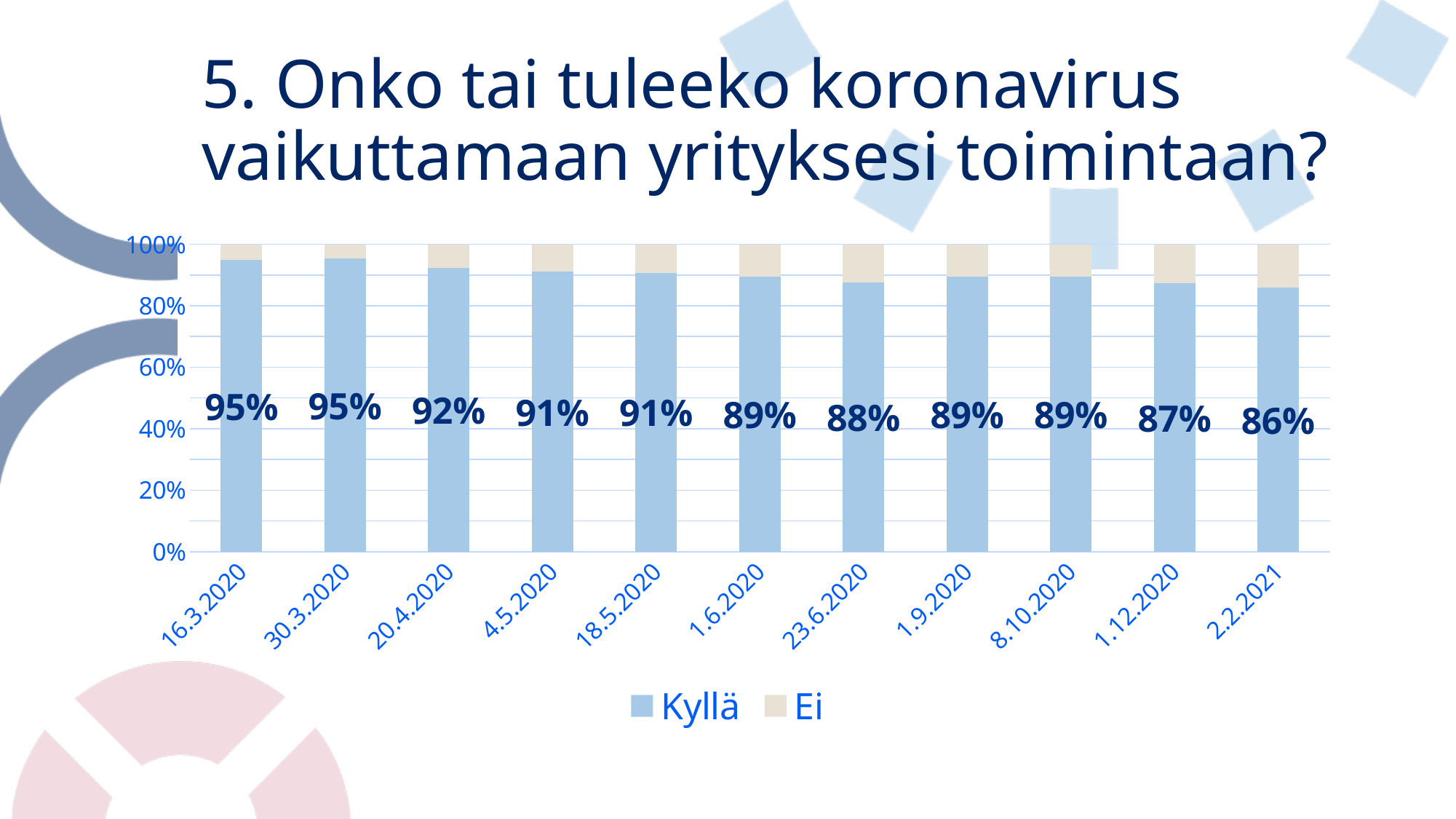
What kind of chart is shown on the slide? stacked bar chart Which is larger, the Kyllä value for 20.4.2020 or the Kyllä value for 1.6.2020? 20.4.2020 What is the Kyllä value for 1.12.2020? 87% Which date has the lowest Kyllä value? 2.2.2021 What is the difference between the Kyllä value for 16.3.2020 and the Kyllä value for 2.2.2021? 9 percentage points How many dates are shown on the x axis? 11 What is the Kyllä value for 23.6.2020? 88% What is the Kyllä value for 16.3.2020? 95% How many series does the legend list? 2 Is the Ei value for 2.2.2021 greater or less than 20%? less What is the Kyllä value for 2.2.2021? 86% Does the Kyllä value generally rise or fall from 16.3.2020 to 2.2.2021? fall